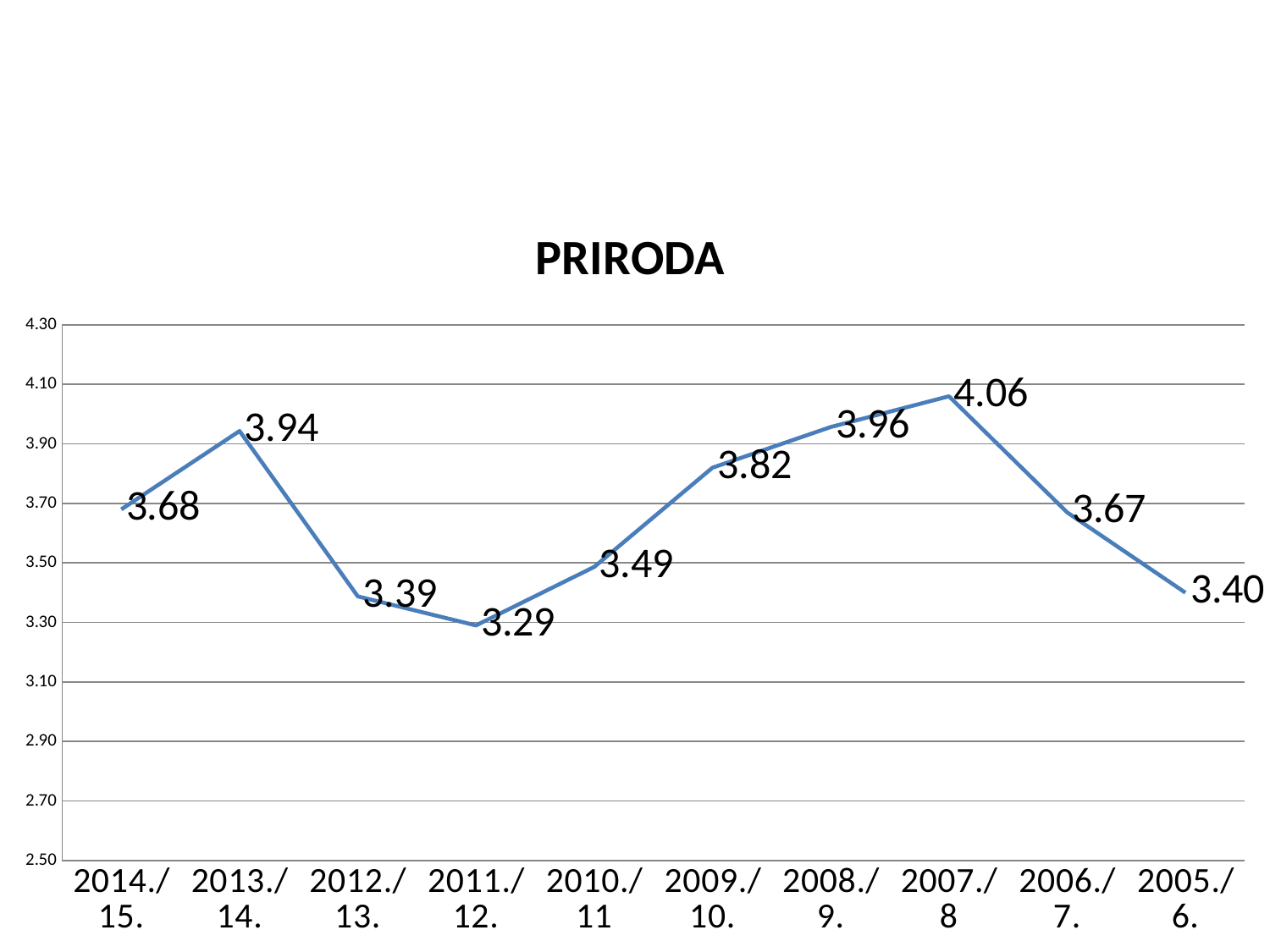
What is the value for 2007./8 in the PRIRODA chart? 4.06 Which school year has the lowest value in the PRIRODA chart? 2011./12. How many school years are plotted in the PRIRODA chart? 10 Which school year has the highest value in the PRIRODA chart? 2007./8 What is the difference between the values for 2013./14. and 2012./13. in the PRIRODA chart? 0.55 What is the value for 2005./6. in the PRIRODA chart? 3.40 Which is larger in the PRIRODA chart: the value for 2009./10. or the value for 2010./11? 2009./10. What is the value for 2014./15. in the PRIRODA chart? 3.68 What is the title of the chart on the slide? PRIRODA What kind of chart is shown on the slide? line chart Is the value for 2008./9. greater or less than 3.90 in the PRIRODA chart? greater What is the value for 2011./12. in the PRIRODA chart? 3.29